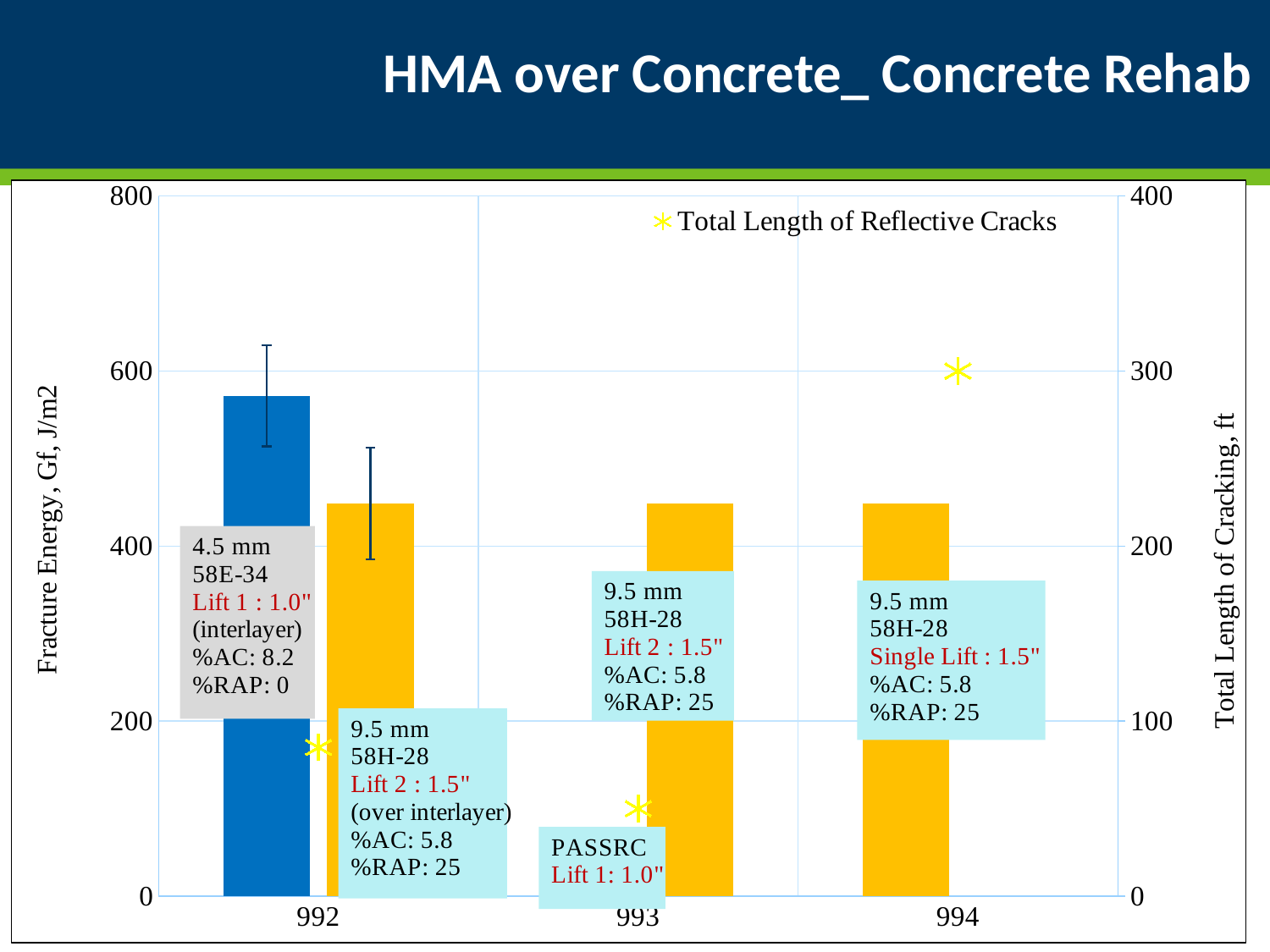
Is the fracture energy of the blue bar at 992 greater or less than 400? greater How many bars are plotted in the chart? 4 What series does the star marker in the legend represent? Total Length of Reflective Cracks At 992, which bar is taller, the blue bar or the yellow bar? the blue bar What kind of chart is shown on the slide? bar chart Is the total length of reflective cracks for 994 greater or less than 200 ft? greater What is the label of the left vertical axis? Fracture Energy, Gf, J/m2 Is the fracture energy of the blue bar at 992 greater or less than 600? less How many categories are shown on the x axis? 3 Which category has the lowest total length of reflective cracks? 993 Which category has the highest total length of reflective cracks? 994